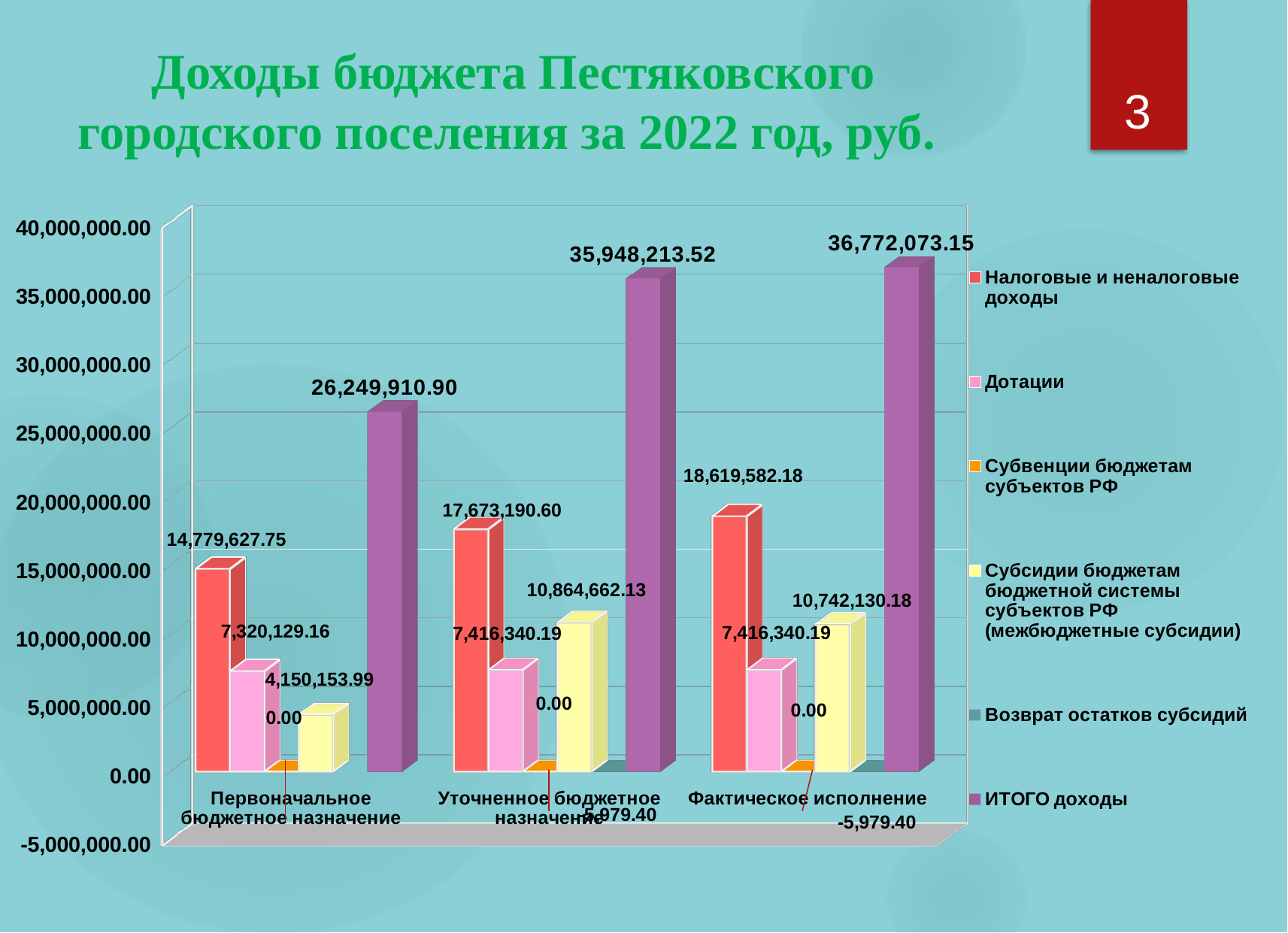
What is the difference between ИТОГО доходы for Фактическое исполнение and for Уточненное бюджетное назначение? 823,859.63 Do the values of Налоговые и неналоговые доходы rise or fall from Первоначальное бюджетное назначение to Фактическое исполнение? rise How many series does the legend list? 6 How many categories are shown on the x axis of the chart? 3 Which category has the highest value of ИТОГО доходы? Фактическое исполнение What is the value of ИТОГО доходы for Фактическое исполнение? 36,772,073.15 What is the value of Налоговые и неналоговые доходы for Первоначальное бюджетное назначение? 14,779,627.75 Which category has the lowest value of Налоговые и неналоговые доходы? Первоначальное бюджетное назначение What is the value of Дотации for Уточненное бюджетное назначение? 7,416,340.19 What is the value of Субсидии бюджетам бюджетной системы субъектов РФ (межбюджетные субсидии) for Фактическое исполнение? 10,742,130.18 What is the value of Возврат остатков субсидий for Фактическое исполнение? -5,979.40 Which is larger: Субсидии бюджетам бюджетной системы субъектов РФ for Уточненное бюджетное назначение or for Фактическое исполнение? Уточненное бюджетное назначение